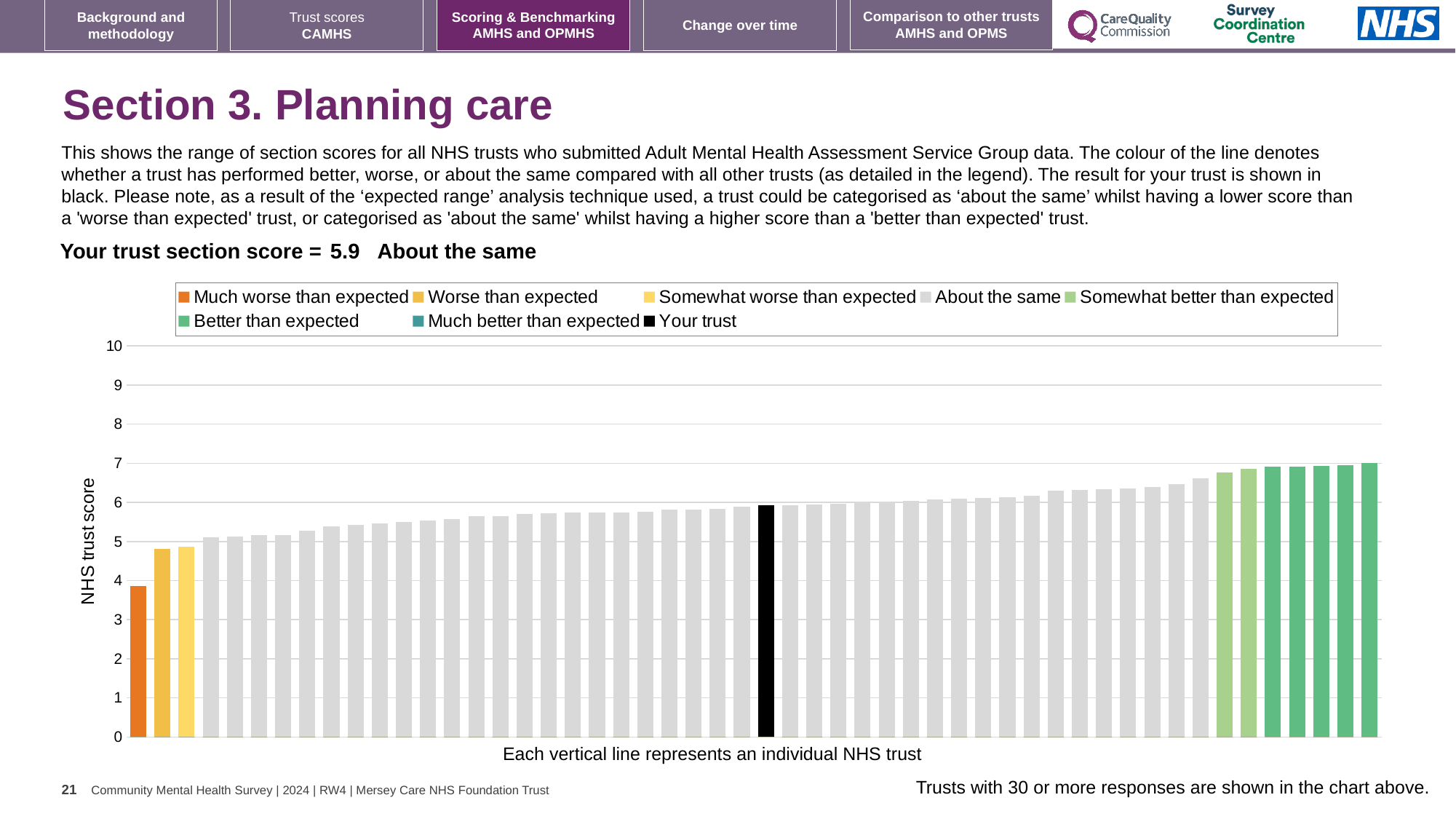
Do the bar values rise or fall from left to right along the x axis? rise Which category is your trust placed in for this section? About the same Is the value of the lowest bar (the orange 'Much worse than expected' trust) greater or less than 4? less What is the label on the vertical axis of the chart? NHS trust score Is the value for your trust (the black bar) greater or less than 5? greater How many bars are coloured as 'Much worse than expected'? 1 What is the section score for your trust shown on the slide? 5.9 Is the value of the highest bar in the chart greater or less than 6? greater What kind of chart is shown on the slide? bar chart How many bars are coloured as 'Worse than expected'? 1 How many entries does the chart legend list? 8